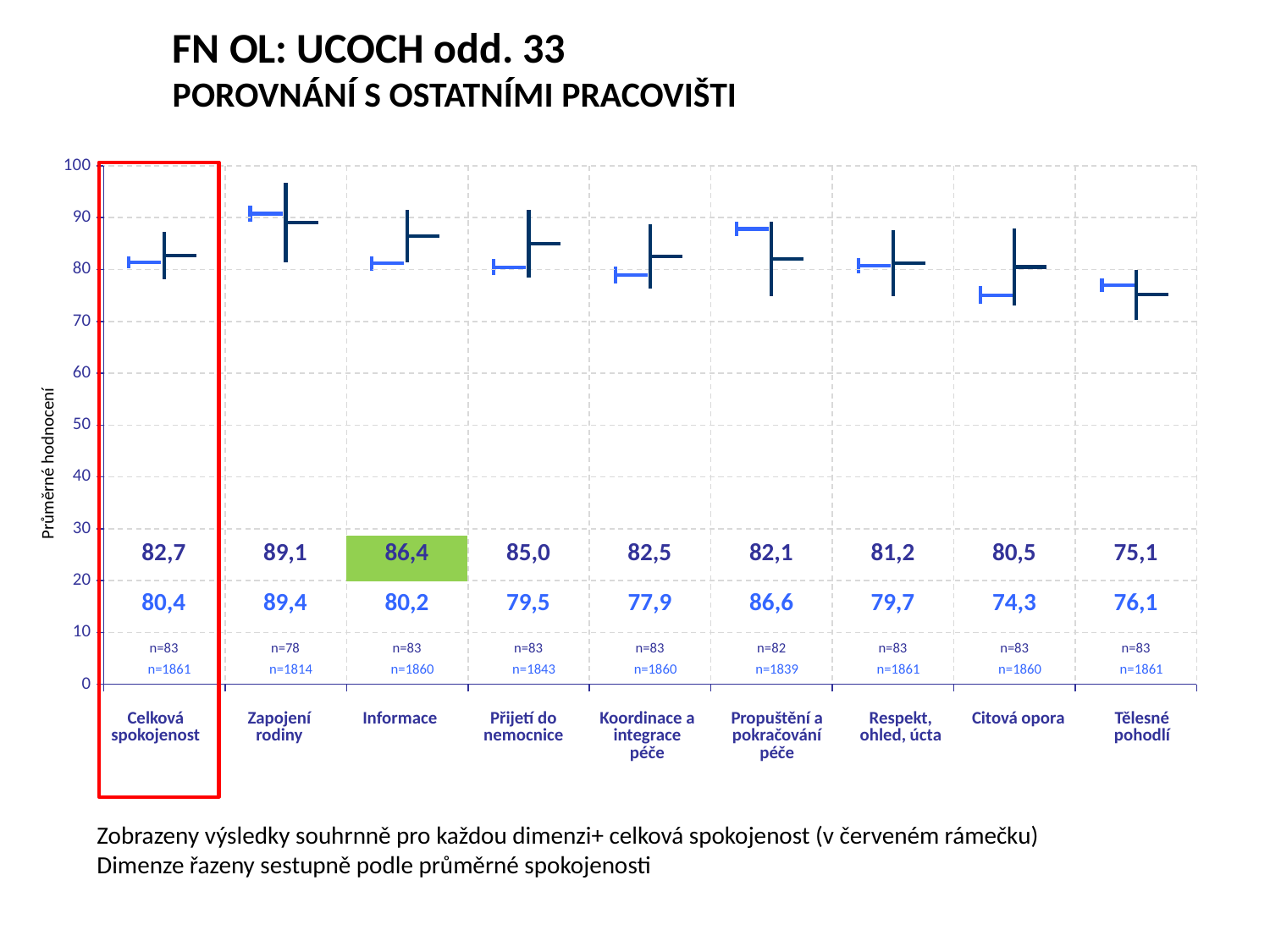
How many categories are shown along the x axis of the chart? 9 What is the upper (dark blue) value shown for Informace? 86,4 What is the lower (light blue) value shown for Propuštění a pokračování péče? 86,6 For Propuštění a pokračování péče, which is larger: the upper (dark blue) value or the lower (light blue) value? the lower (light blue) value What is the difference between the upper (dark blue) value and the lower (light blue) value for Informace? 6,2 Which category has the lowest upper (dark blue) value? Tělesné pohodlí Which value is highlighted with a green background? 86,4 Which category has the lowest lower (light blue) value? Citová opora What is the difference between the upper (dark blue) value and the lower (light blue) value for Celková spokojenost? 2,3 Which category is enclosed in the red frame? Celková spokojenost Which category has the highest upper (dark blue) value? Zapojení rodiny What is the first n value printed under Zapojení rodiny? n=78